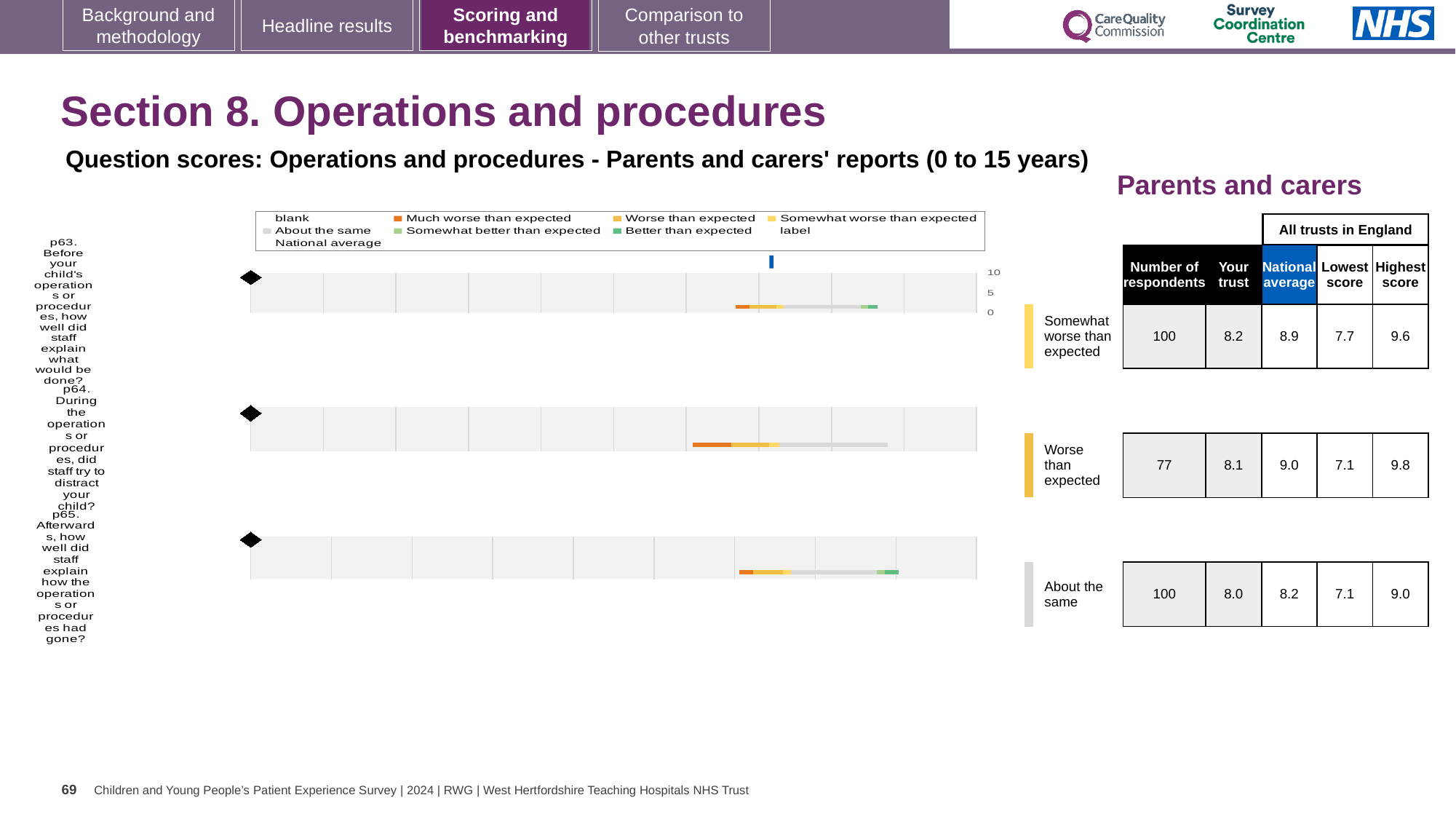
Which has the larger 'Your trust' score: the p63 chart or the p65 chart? p63 What benchmark category label is shown next to the p64 chart? Worse than expected For the p64 chart, what is the number of respondents? 77 What kind of chart is used for each question on this slide? bar chart For the p64 chart (During the operations or procedures, did staff try to distract your child?), what is the national average score? 9.0 Which of the three question charts has the highest 'Your trust' score? p63 For the p63 chart, what is the highest score among all trusts in England? 9.6 For the p63 chart (Before your child's operations or procedures, how well did staff explain what would be done?), what is the 'Your trust' score shown in the table? 8.2 For the p64 chart, what is the difference between the national average and the 'Your trust' score? 0.9 How many question charts are shown on the slide? 3 For the p65 chart (Afterwards, how well did staff explain how the operations or procedures had gone?), how many respondents are listed? 100 What benchmark category label is shown next to the p65 chart? About the same